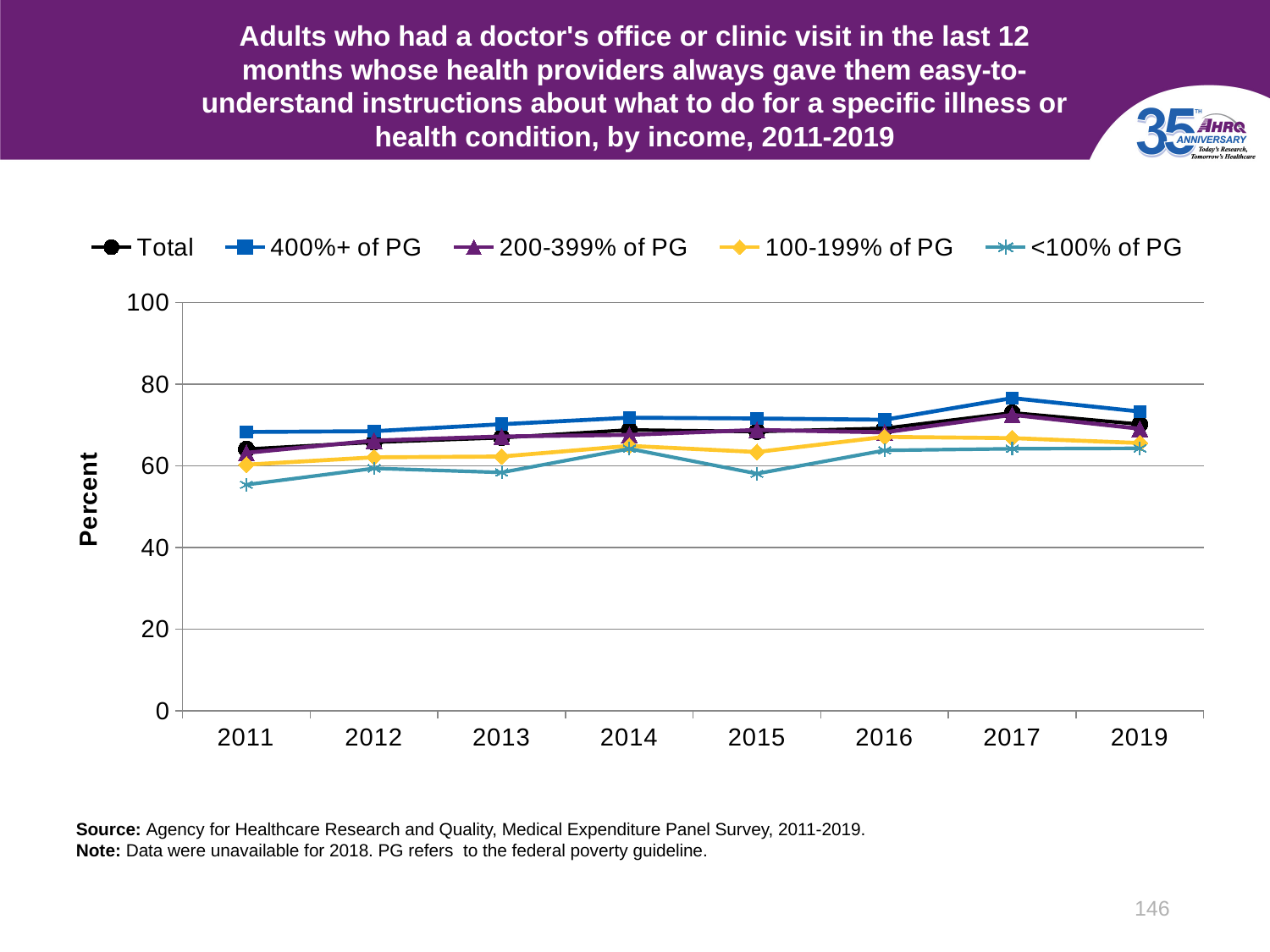
In 2015, which is larger: the value for 100-199% of PG or the value for <100% of PG? 100-199% of PG Does the Total series rise or fall from 2011 to 2017? rise Is the value for Total in 2019 greater or less than 60? greater What kind of chart is shown on the slide? line chart In which year is the value for <100% of PG lowest? 2011 In 2011, which is larger: the value for 400%+ of PG or the value for <100% of PG? 400%+ of PG In which year is the value for 400%+ of PG highest? 2017 What is the label on the y axis? Percent How many years are plotted along the x axis? 8 How many series does the legend list? 5 Is the value for 400%+ of PG in 2017 greater or less than 80? less Is the value for <100% of PG in 2011 greater or less than 60? less